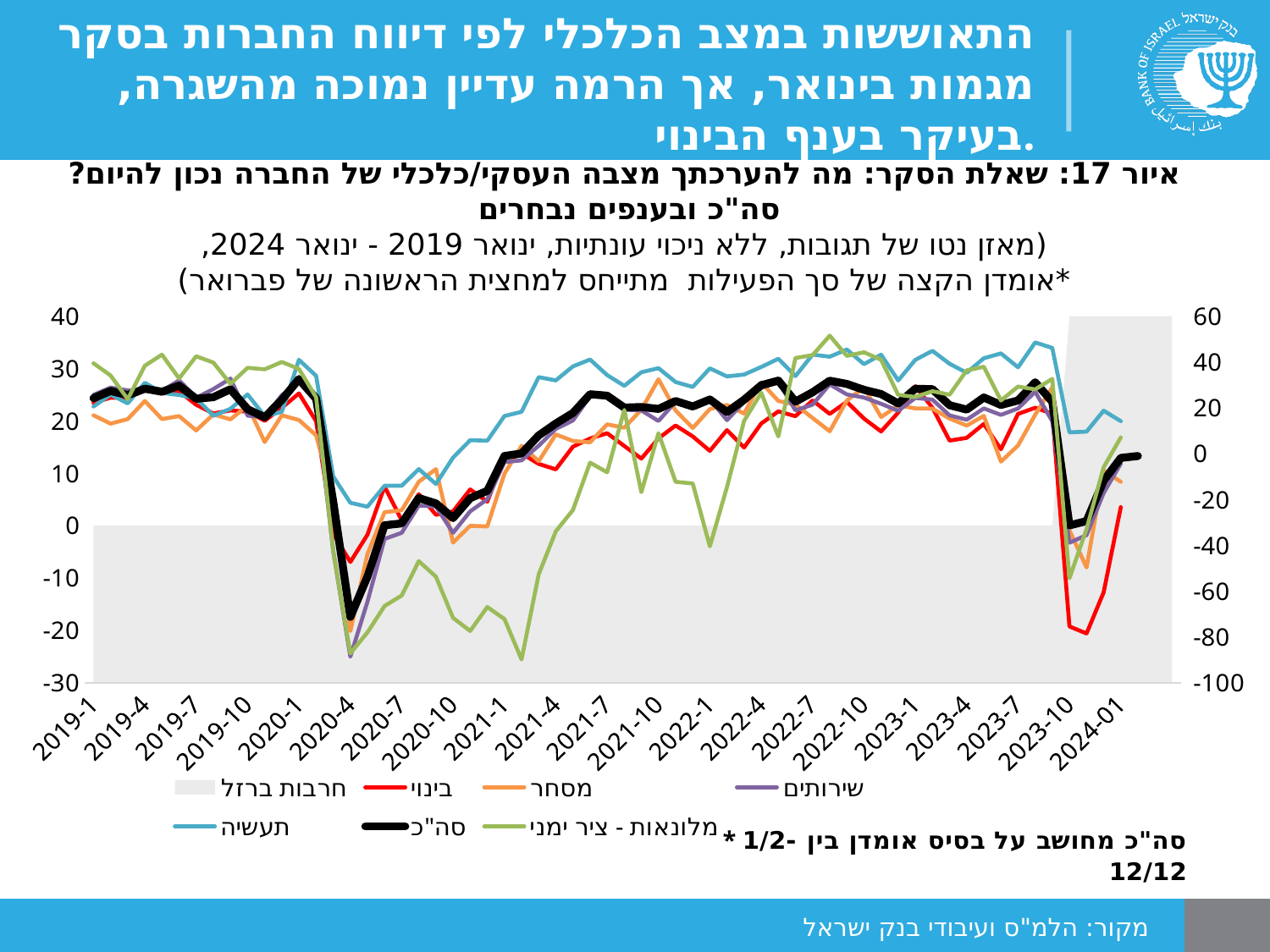
Does the סה"כ line rise or fall between 2023-7 and 2023-10? fall How many entries does the chart legend list? 7 Is the value for תעשיה at 2020-4 greater or less than 0? greater At 2023-10, which is larger: the value for בינוי or the value for תעשיה? תעשיה Does the סה"כ line rise or fall between 2020-4 and 2021-7? rise Which series has the lowest value at 2023-10 on the left axis? בינוי Is the value for סה"כ at 2019-1 greater or less than 20? greater Is the value for סה"כ at 2020-4 greater or less than 0? less Which legend entry is shown as a grey shaded area rather than a line? חרבות ברזל What kind of chart is shown on the slide? line chart Which series in the legend is plotted against the right-hand axis? מלונאות - ציר ימני